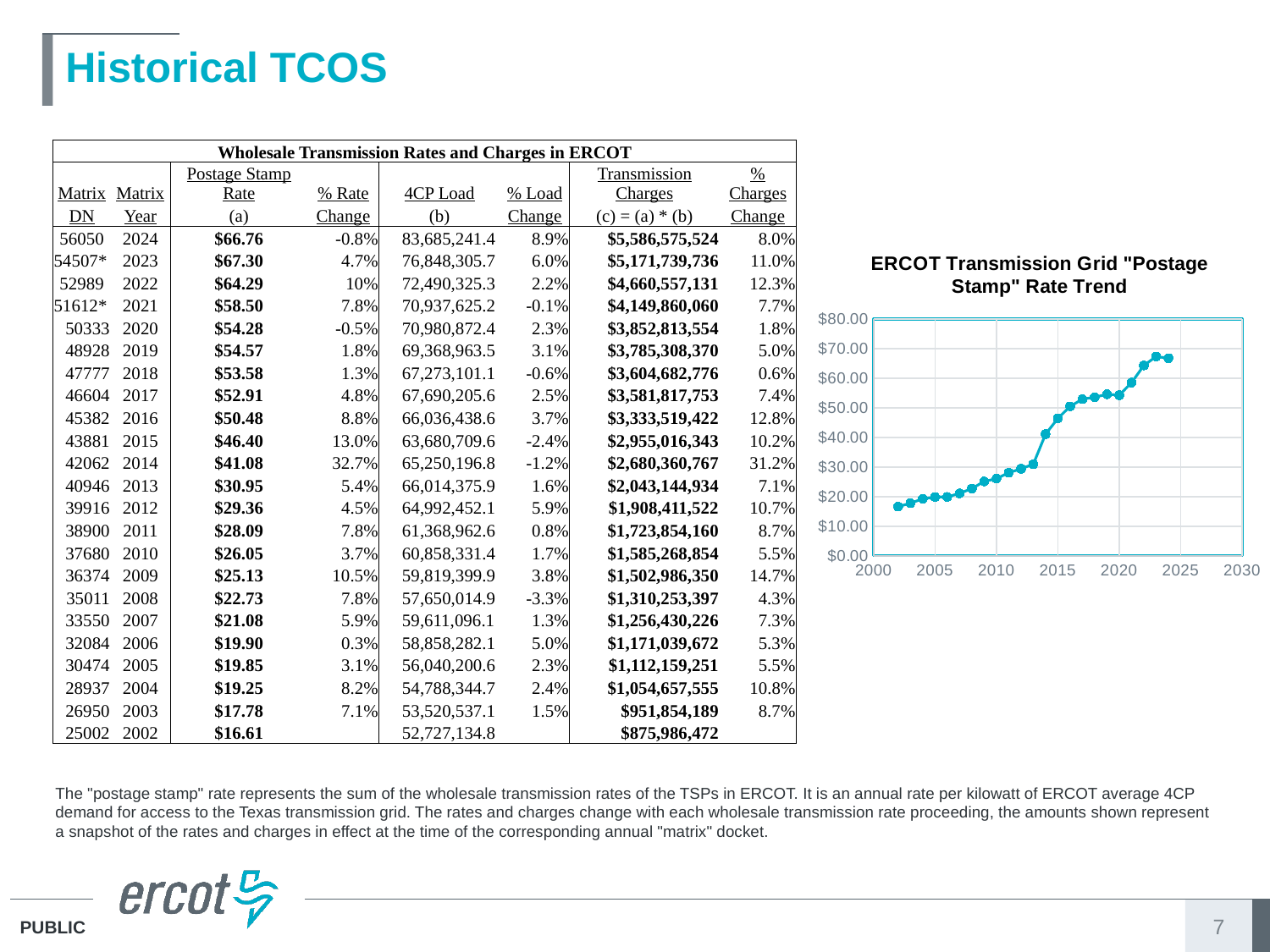
How many data points are plotted in the "Postage Stamp" Rate Trend chart? 23 In the "Postage Stamp" Rate Trend chart, is the value for 2020 greater or less than $50.00? greater In the "Postage Stamp" Rate Trend chart, do the values generally rise or fall from 2002 to 2024? rise In the "Postage Stamp" Rate Trend chart, is the value for 2015 greater or less than $40.00? greater In the "Postage Stamp" Rate Trend chart, is the value for 2010 greater or less than $30.00? less What is the title of the chart on the right side of the slide? ERCOT Transmission Grid "Postage Stamp" Rate Trend In the "Postage Stamp" Rate Trend chart, which year has the lowest value? 2002 In the "Postage Stamp" Rate Trend chart, which is larger, the value for 2015 or the value for 2010? 2015 What kind of chart is the "ERCOT Transmission Grid "Postage Stamp" Rate Trend" chart? line chart In the "Postage Stamp" Rate Trend chart, what is the highest value shown on the vertical axis? $80.00